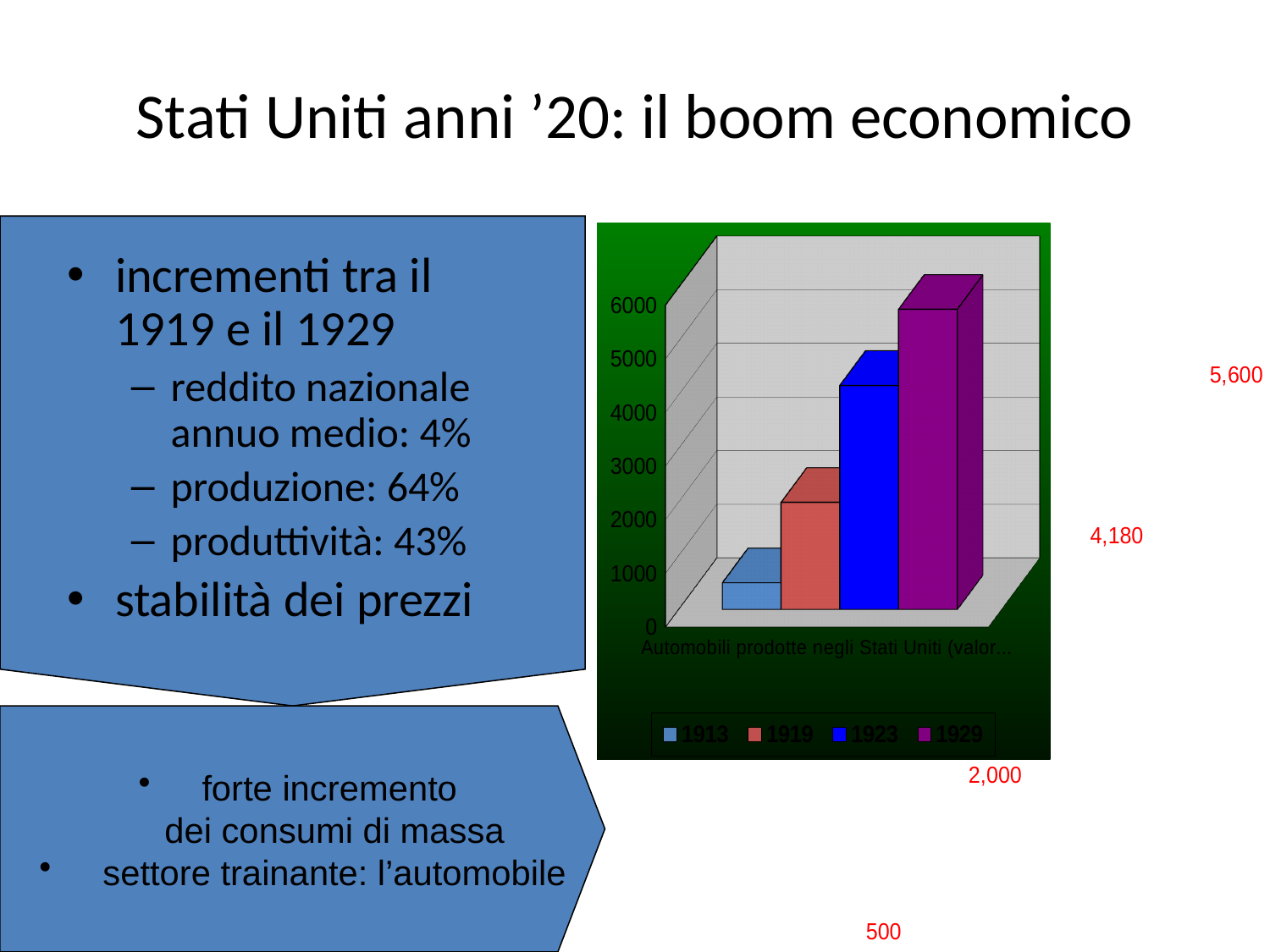
Is the value for 1919 greater or less than 1000? greater Is the value for 1923 greater or less than 3000? greater Which bar is taller, 1923 or 1919? 1923 What kind of chart is shown on the slide? bar chart How many series does the chart legend list? 4 What is the highest value shown on the chart's vertical axis? 6000 Do the bars rise or fall from 1913 to 1929? rise Is the value for 1929 greater or less than 5000? greater What colour is the bar for 1929 in the chart? purple Which series has the highest bar in the chart? 1929 Which series has the lowest bar in the chart? 1913